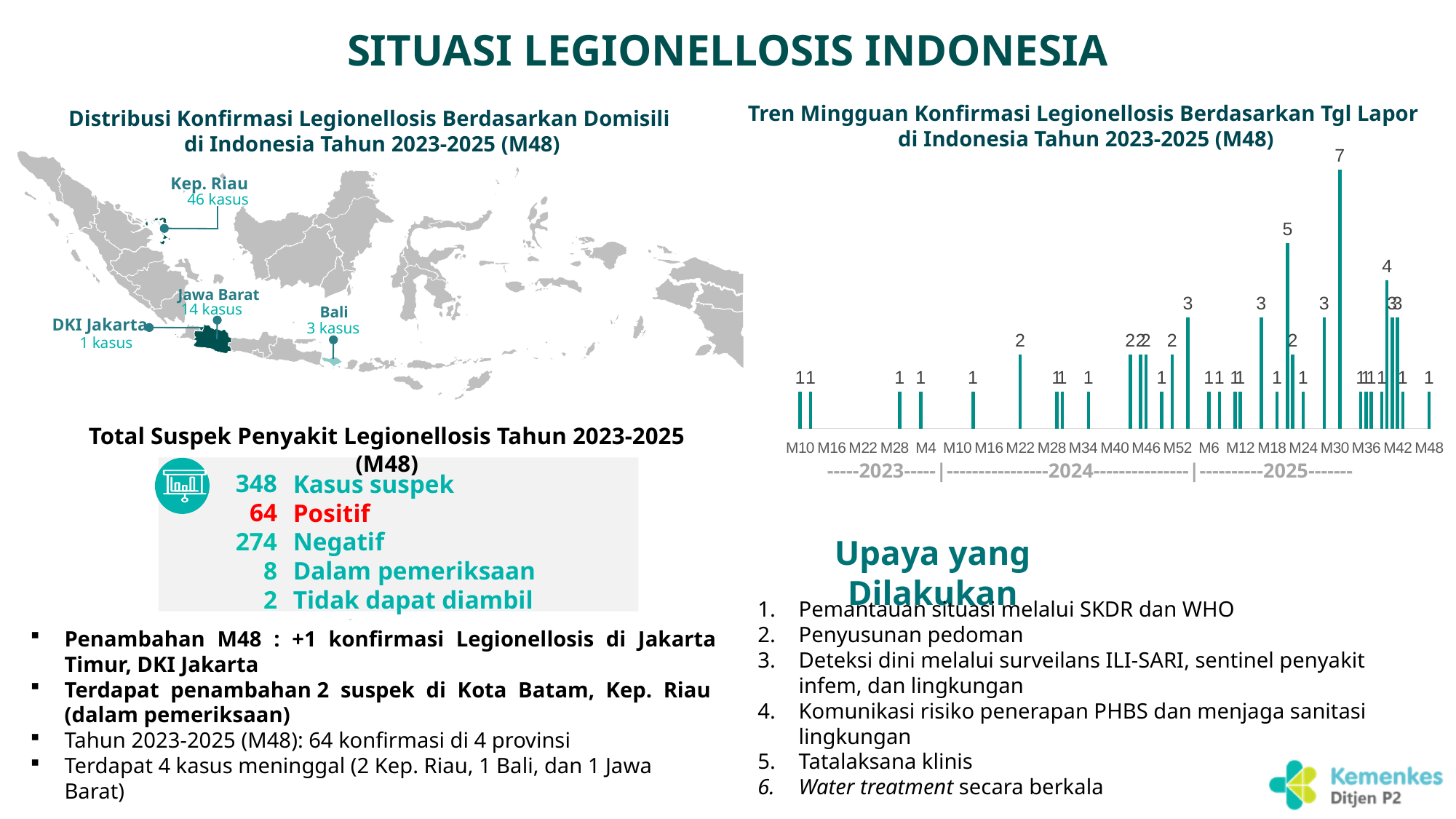
In the 'Tren Mingguan Konfirmasi Legionellosis' chart, what is the smallest value labelled on a bar? 1 On the map 'Distribusi Konfirmasi Legionellosis Berdasarkan Domisili', which province has the most cases? Kep. Riau In the 'Tren Mingguan Konfirmasi Legionellosis' chart, what is the difference between the tallest bar (7) and the second tallest bar (5)? 2 On the map 'Distribusi Konfirmasi Legionellosis Berdasarkan Domisili', how many cases are labelled for Kep. Riau? 46 kasus In the 'Tren Mingguan Konfirmasi Legionellosis' chart, in which year section does the tallest bar (7) appear? 2025 In the 'Tren Mingguan Konfirmasi Legionellosis' chart, what is the highest value labelled on any bar? 7 In the 'Tren Mingguan Konfirmasi Legionellosis' chart, how many tick labels are shown on the x axis? 21 On the map 'Distribusi Konfirmasi Legionellosis Berdasarkan Domisili', what is the difference in cases between Kep. Riau and Jawa Barat? 32 On the map 'Distribusi Konfirmasi Legionellosis Berdasarkan Domisili', which province has the fewest cases? DKI Jakarta In the 'Tren Mingguan Konfirmasi Legionellosis' chart, what is the last label on the x axis? M48 What kind of chart is the 'Tren Mingguan Konfirmasi Legionellosis' chart on the right? bar chart In the 'Tren Mingguan Konfirmasi Legionellosis' chart, are the larger bars (values of 3 or more) found mostly in 2023 or in 2025? 2025